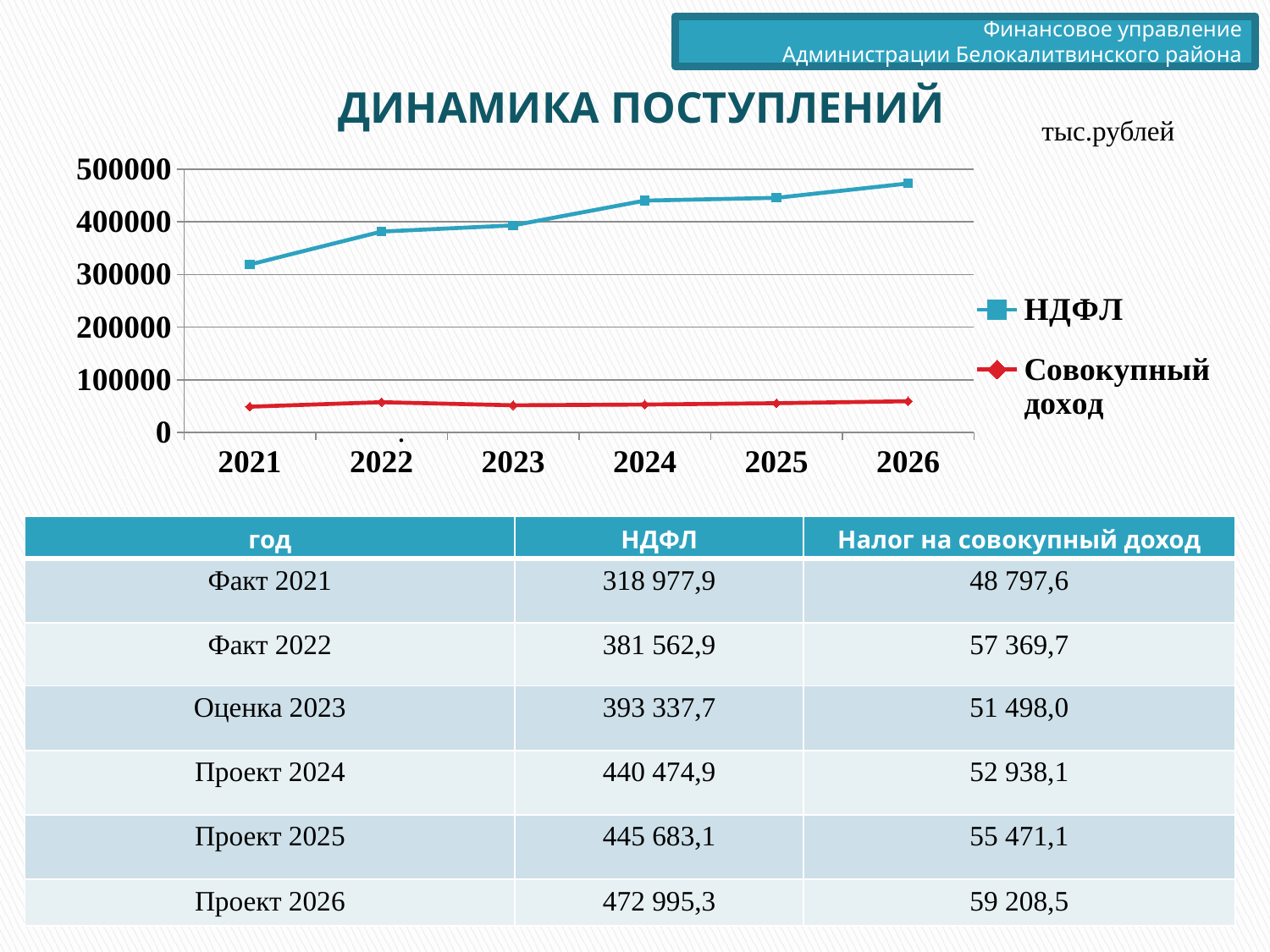
What is the title of the chart? ДИНАМИКА ПОСТУПЛЕНИЙ How many series does the chart legend list? 2 Is the Совокупный доход value for 2023 greater or less than 100000? less What kind of chart is shown on the slide? line chart Which series has the larger value in 2025, НДФЛ or Совокупный доход? НДФЛ What is the Налог на совокупный доход value for 2026 according to the table on the slide? 59 208,5 What is the НДФЛ value for 2021 according to the table on the slide? 318 977,9 In which year is the НДФЛ series at its highest? 2026 Is the НДФЛ value for 2024 greater or less than 400000? greater In which year is the НДФЛ series at its lowest? 2021 How many years are plotted along the x axis of the chart? 6 Does the НДФЛ series rise or fall from 2021 to 2026? rise